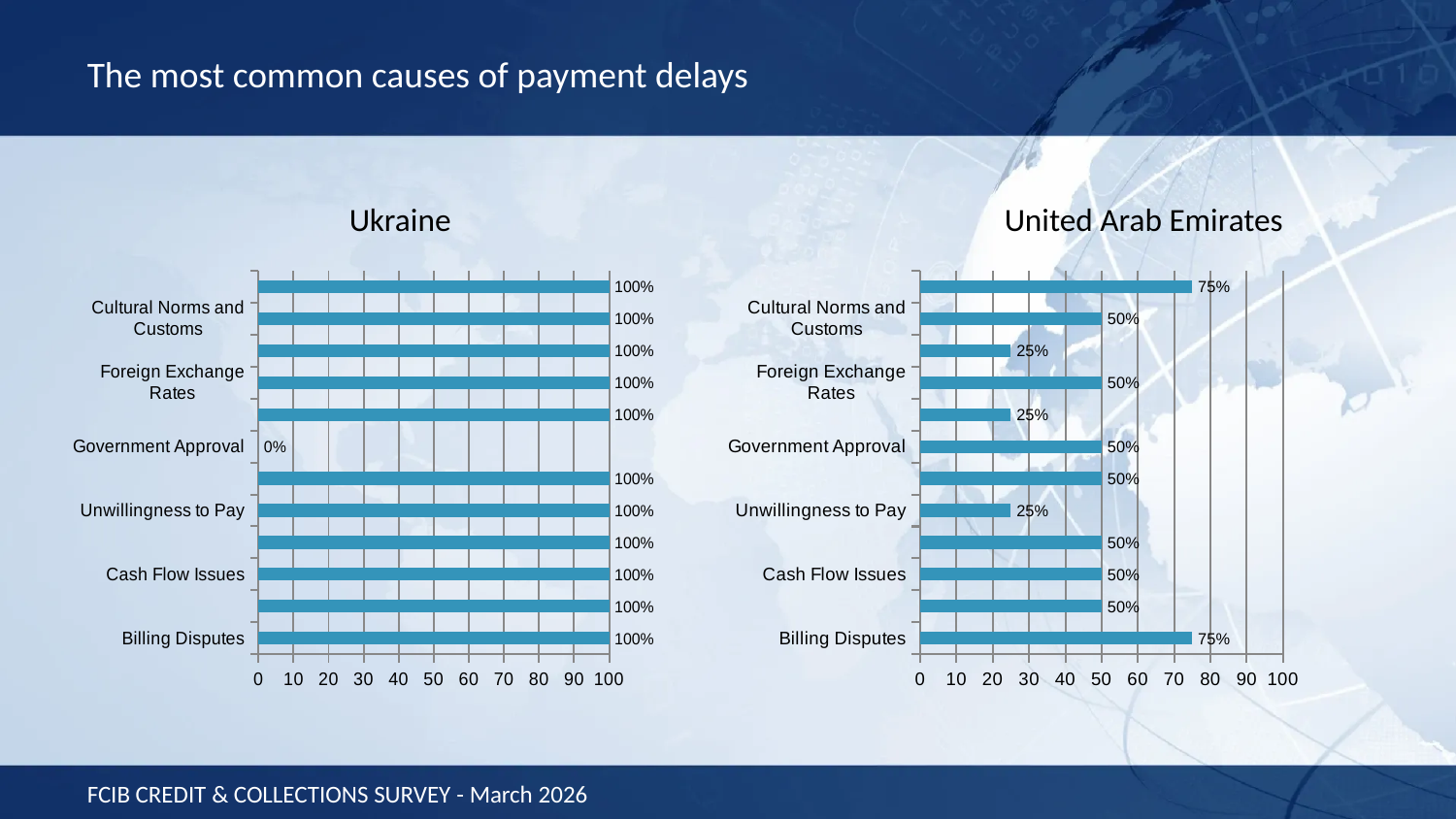
In the Ukraine chart, what is the value for Government Approval? 0% In the United Arab Emirates chart, what is the value for Cash Flow Issues? 50% In the United Arab Emirates chart, what is the value for Unwillingness to Pay? 25% In the United Arab Emirates chart, is the value for Government Approval greater or less than 40? greater In the United Arab Emirates chart, what is the value for Billing Disputes? 75% In the United Arab Emirates chart, which is larger: Billing Disputes or Cash Flow Issues? Billing Disputes How many bars are plotted in the Ukraine chart? 12 In the Ukraine chart, what is the value for Billing Disputes? 100% What kind of chart is used for the Ukraine data? Bar chart In the United Arab Emirates chart, what is the difference between the values for Billing Disputes and Unwillingness to Pay? 50% What is the title of the chart on the right side of the slide? United Arab Emirates In the Ukraine chart, which labelled category has the lowest value? Government Approval